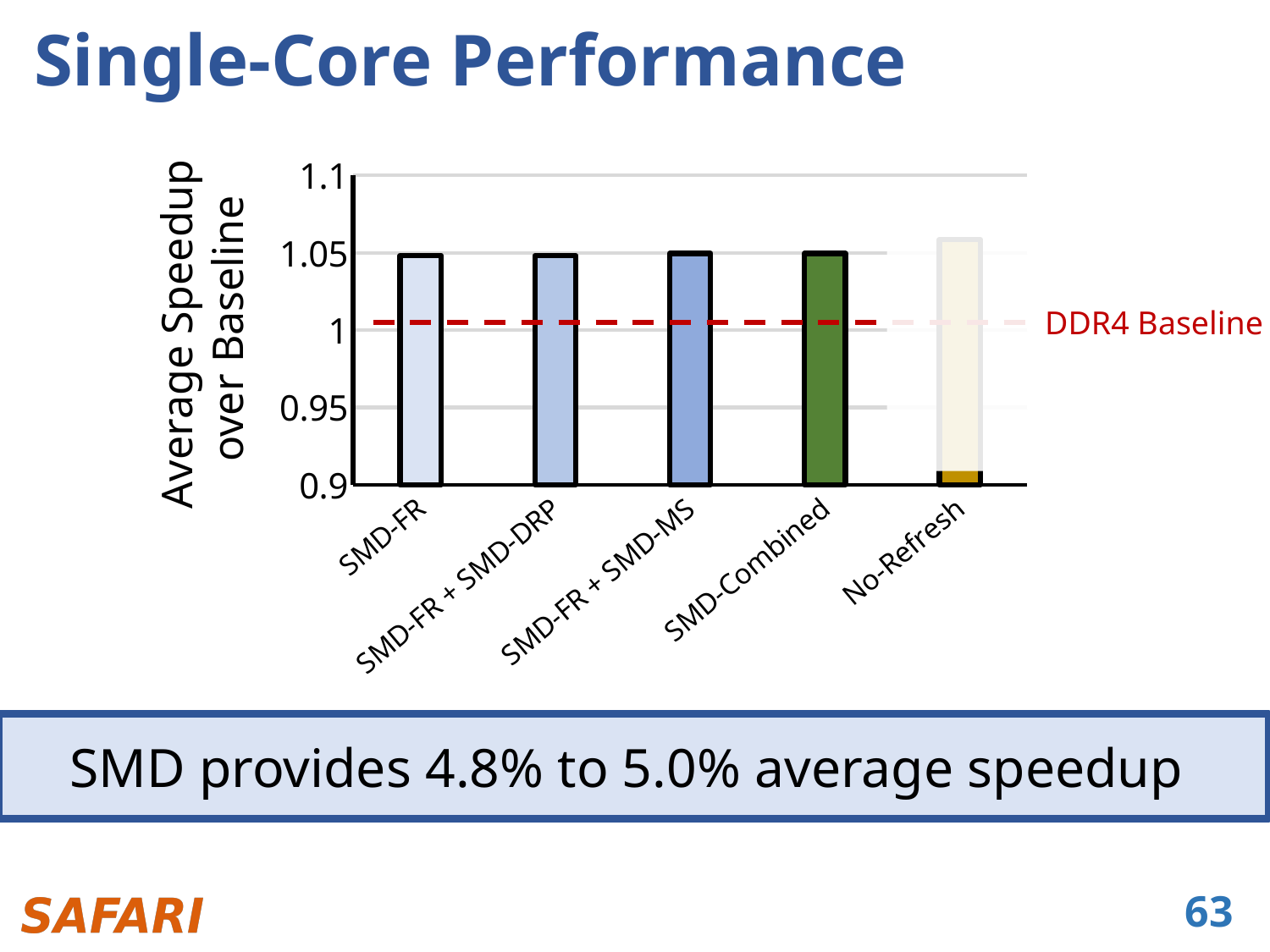
Which is larger, the value for No-Refresh or the value for SMD-FR? No-Refresh What is the label of the y axis? Average Speedup over Baseline Is the value for SMD-FR greater or less than 1? greater Which category has the highest average speedup over baseline? No-Refresh Is the value for SMD-FR + SMD-MS greater or less than 0.95? greater What is the highest tick value shown on the y axis? 1.1 What kind of chart is shown on the slide? bar chart Is the value for SMD-Combined greater or less than 1.1? less How many categories are plotted on the x axis of the chart? 5 What does the red dashed horizontal line represent? DDR4 Baseline What is the label of the fourth bar from the left? SMD-Combined